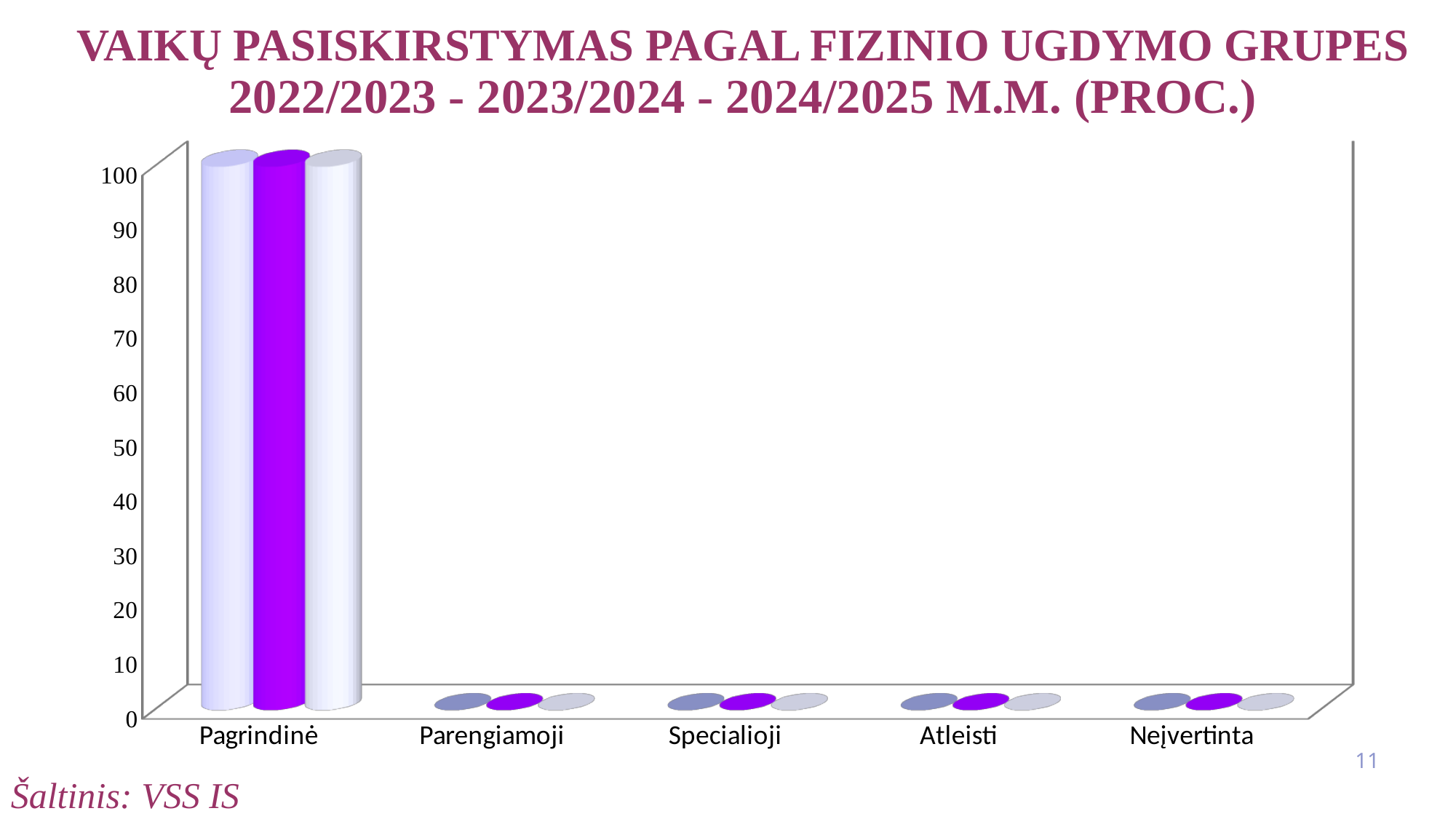
Is the value of the first bar for Parengiamoji greater or less than 10? less Which is larger: the value for Pagrindinė or the value for Specialioji? Pagrindinė What is the source cited below the chart? VSS IS Which category has the highest values in the chart? Pagrindinė Is the value of the middle bar for Atleisti greater or less than 10? less How many categories are shown on the x axis of the chart? 5 What kind of chart is shown on the slide? bar chart What is the highest tick value shown on the vertical axis of the chart? 100 Is the value of the middle (purple) bar for Pagrindinė greater or less than 90? greater How many bars are plotted for each category in the chart? 3 Which is larger: the value for Neįvertinta or the value for Pagrindinė? Pagrindinė